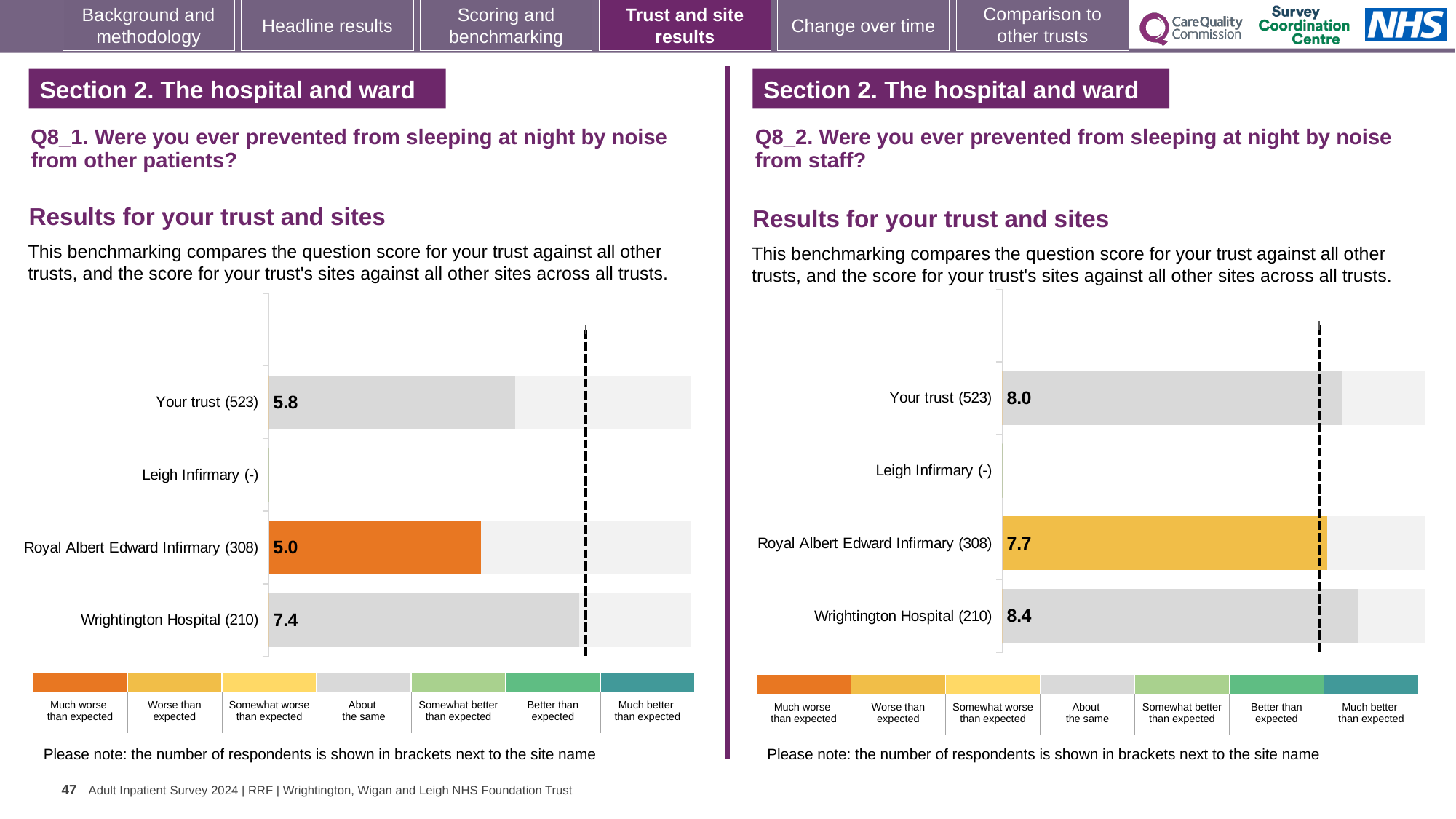
In the Q8_2 chart (noise from staff), what is the score for Wrightington Hospital? 8.4 In the Q8_2 chart (noise from staff), which site has the lowest score? Royal Albert Edward Infirmary In the Q8_2 chart (noise from staff), which has a higher score: Your trust or Royal Albert Edward Infirmary? Your trust In the Q8_1 chart (noise from other patients), which site has the highest score? Wrightington Hospital What type of chart is used in the Q8_1 chart (noise from other patients)? Bar chart In the Q8_1 chart (noise from other patients), how many respondents are shown in brackets for Royal Albert Edward Infirmary? 308 In the Q8_2 chart (noise from staff), what is the score for Your trust? 8.0 In the Q8_2 chart (noise from staff), what is the difference between the scores for Wrightington Hospital and Your trust? 0.4 In the Q8_1 chart (noise from other patients), what is the score for Royal Albert Edward Infirmary? 5.0 In the Q8_1 chart (noise from other patients), what is the score for Your trust? 5.8 In the Q8_1 chart (noise from other patients), what is the difference between the scores for Wrightington Hospital and Royal Albert Edward Infirmary? 2.4 In the Q8_1 chart (noise from other patients), what is the score for Wrightington Hospital? 7.4